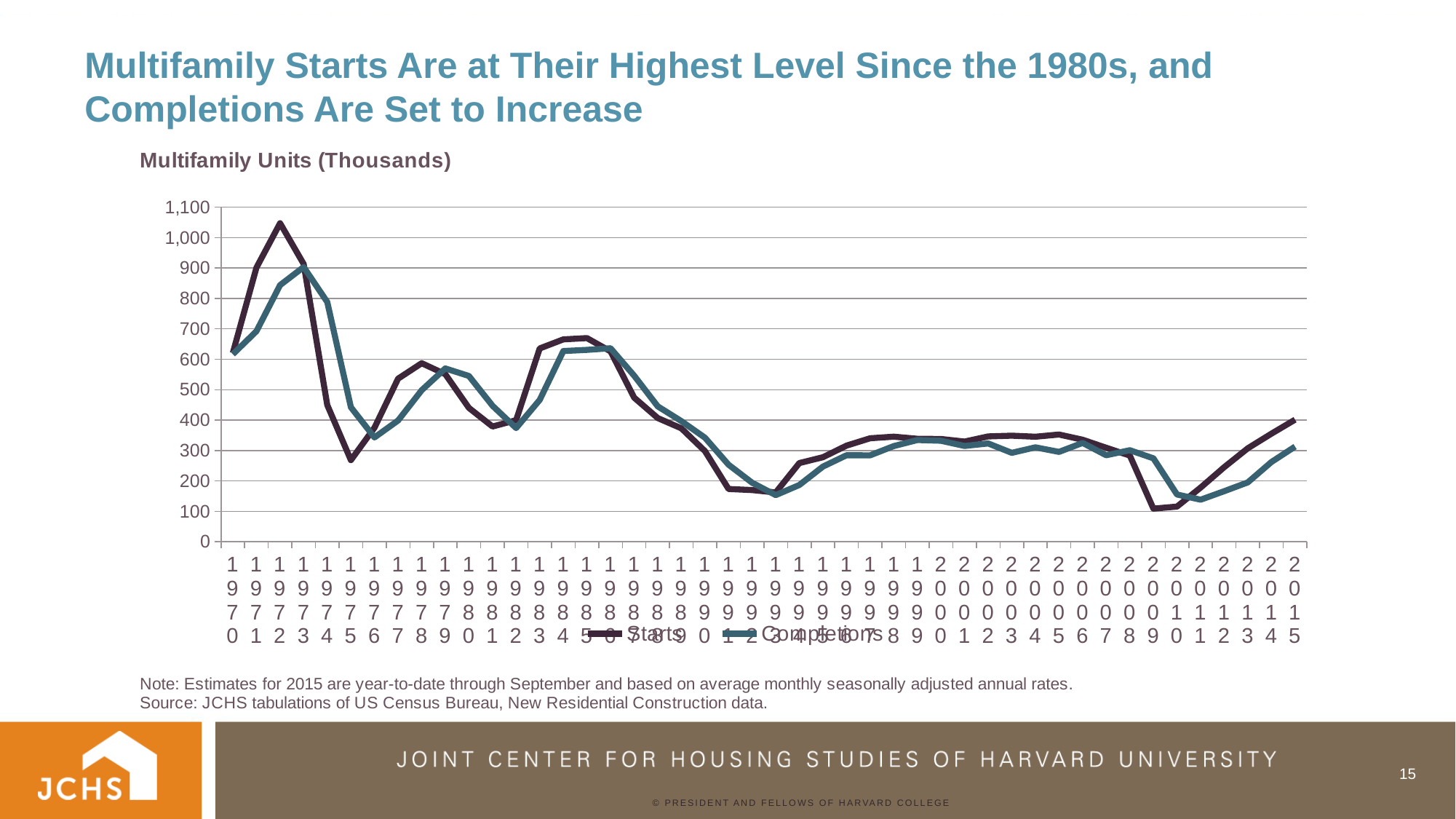
What are the two series named in the legend? Starts and Completions How many series does the legend list? 2 In which year does the Starts series reach its highest value? 1972 Is the value of Starts in 1975 greater or less than 300? less Do Starts rise or fall from 2009 to 2015? Rise In which year does the Starts series reach its lowest value? 2009 What kind of chart is shown on the slide? Line chart What is the label on the vertical axis of the chart? Multifamily Units (Thousands) Is the value of Starts in 1972 greater or less than 1,000? greater Is the value of Starts in 2009 greater or less than 200? less In 2015, which series has the larger value, Starts or Completions? Starts